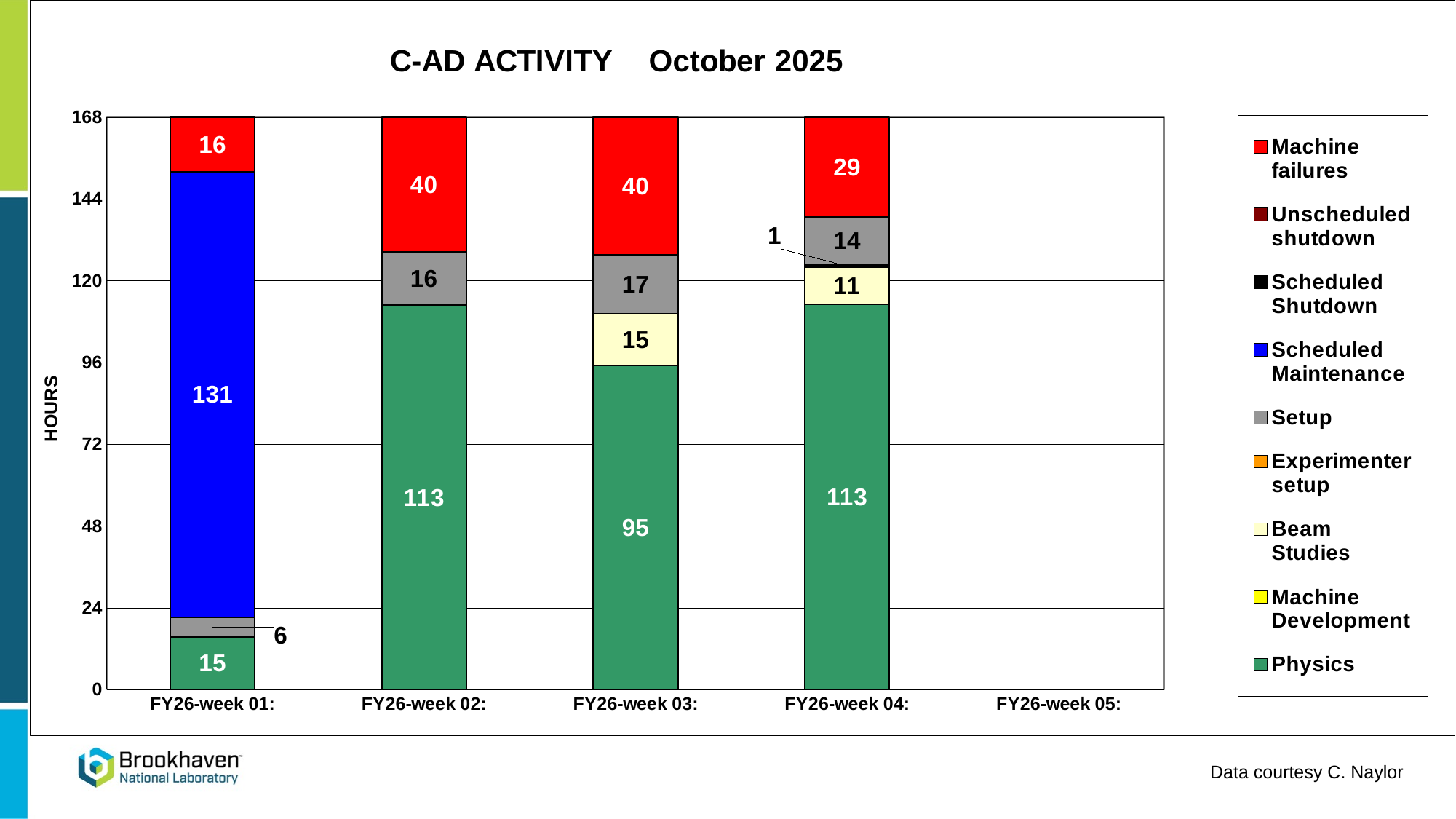
Which week has more Setup hours, FY26-week 02 or FY26-week 03? FY26-week 03 What is the difference in Machine failures hours between FY26-week 02 and FY26-week 01? 24 How many hours of Scheduled Maintenance are shown for FY26-week 01? 131 How many hours of Physics are shown for FY26-week 02? 113 Which week has the lowest number of Physics hours? FY26-week 01 How many series does the legend list? 9 How many hours of Beam Studies are shown for FY26-week 03? 15 What kind of chart is shown on the slide? stacked bar chart How many hours of Machine failures are shown for FY26-week 04? 29 What is the label on the y axis? HOURS How many hours of Setup are shown for FY26-week 01? 6 How many week categories are shown on the x axis? 5